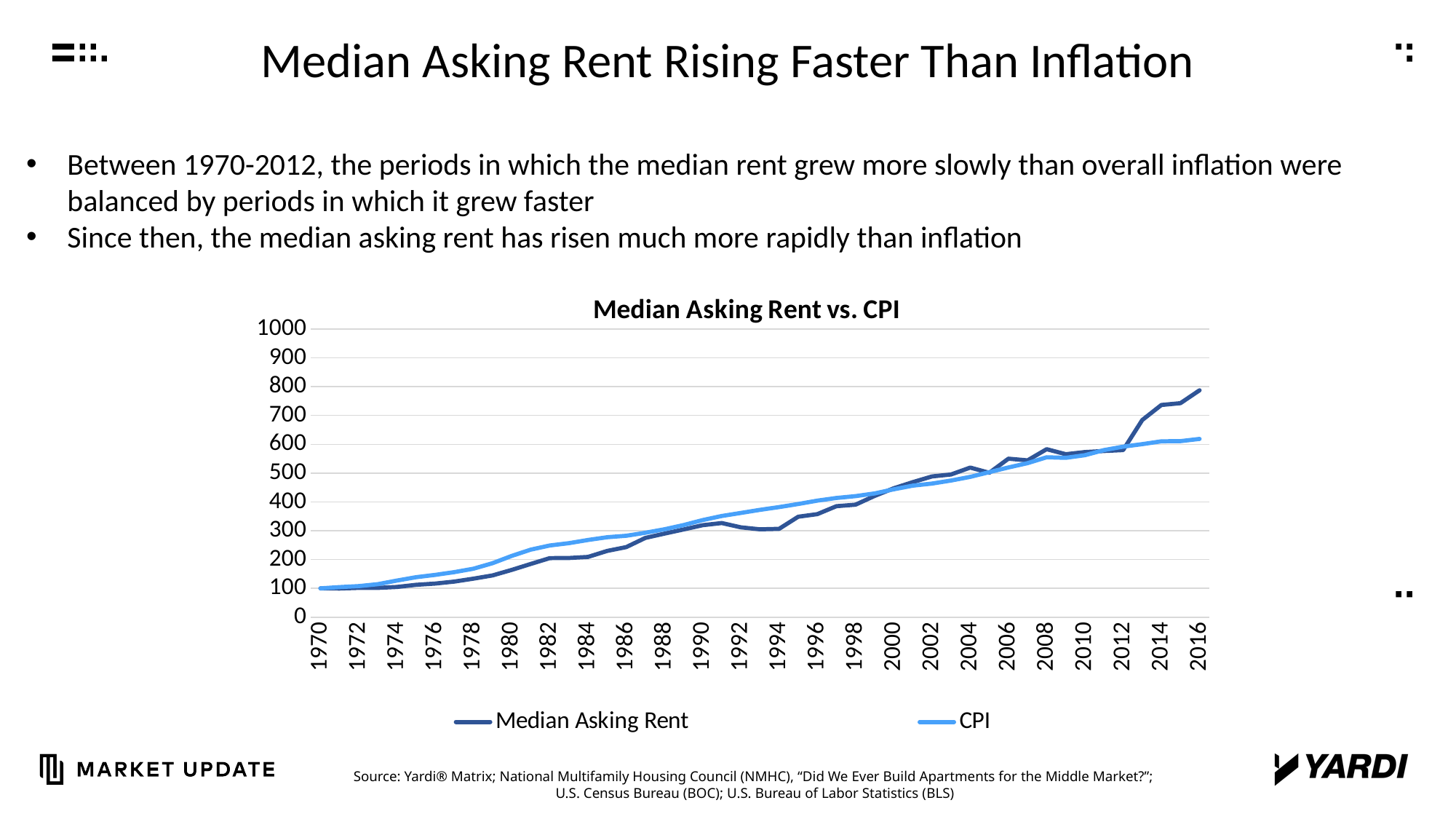
What is the value of Median Asking Rent in 1970? 100 What is the title of the chart? Median Asking Rent vs. CPI Is the value for CPI in 1982 greater or less than 200? greater Is the value for Median Asking Rent in 2016 greater or less than 700? greater How many series does the legend list? 2 What is the value of CPI in 1970? 100 What are the two series named in the legend? Median Asking Rent and CPI Is the value for Median Asking Rent in 1994 greater or less than 400? less In 1994, which series has the higher value, Median Asking Rent or CPI? CPI What kind of chart is shown on the slide? Line chart In 2016, which series has the higher value, Median Asking Rent or CPI? Median Asking Rent